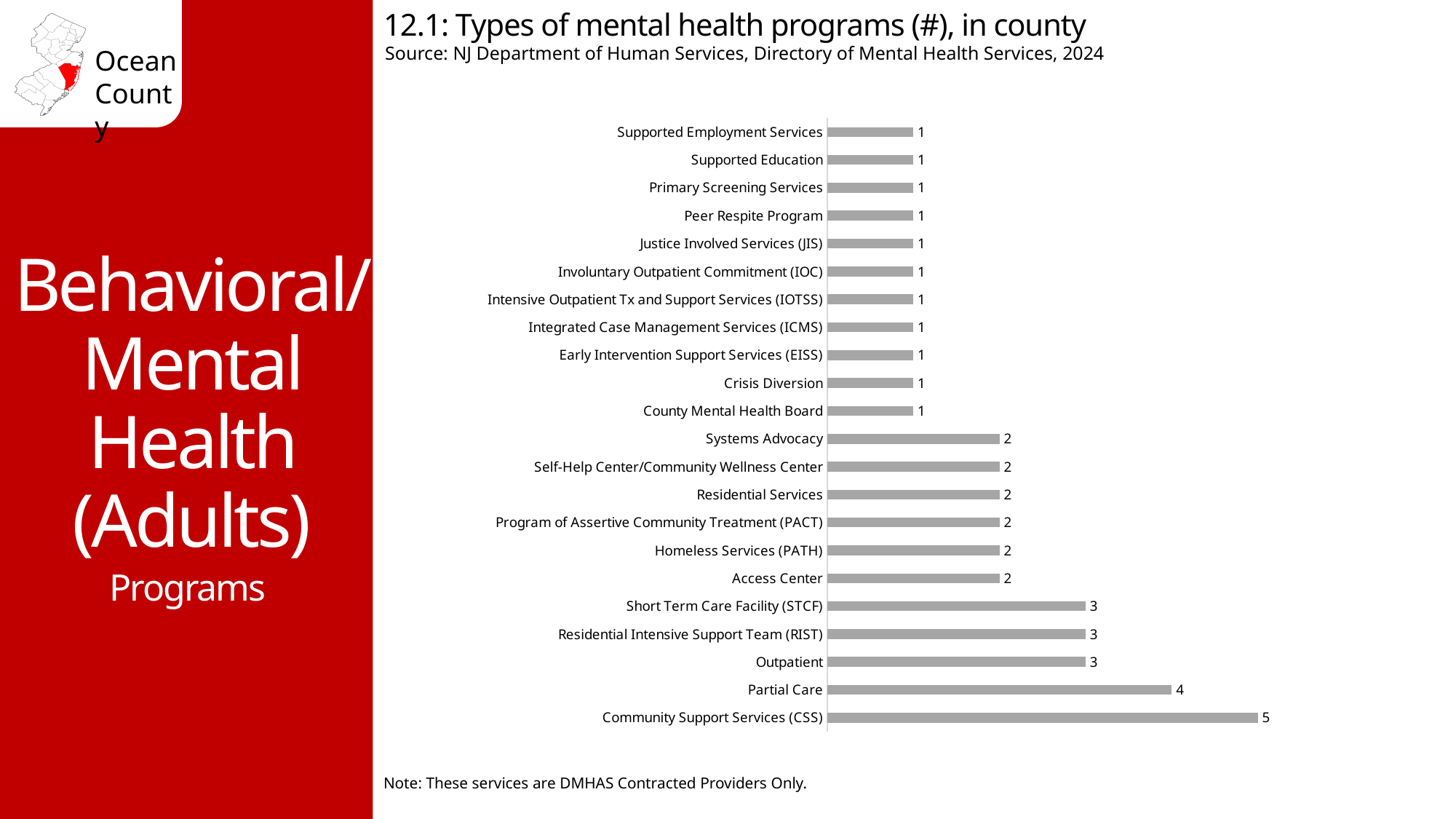
What is the difference between the values for Community Support Services (CSS) and Partial Care? 1 What is the value for Outpatient? 3 How many categories are shown in the chart? 22 What is the value for Homeless Services (PATH)? 2 What is the value for Crisis Diversion? 1 What is the difference between the values for Short Term Care Facility (STCF) and Systems Advocacy? 1 Which is larger, the value for Residential Intensive Support Team (RIST) or the value for Access Center? Residential Intensive Support Team (RIST) What is the value for Partial Care? 4 What kind of chart is shown on the slide? Bar chart Which category has the highest value? Community Support Services (CSS) What is the title of the chart? 12.1: Types of mental health programs (#), in county What is the value for Community Support Services (CSS)? 5